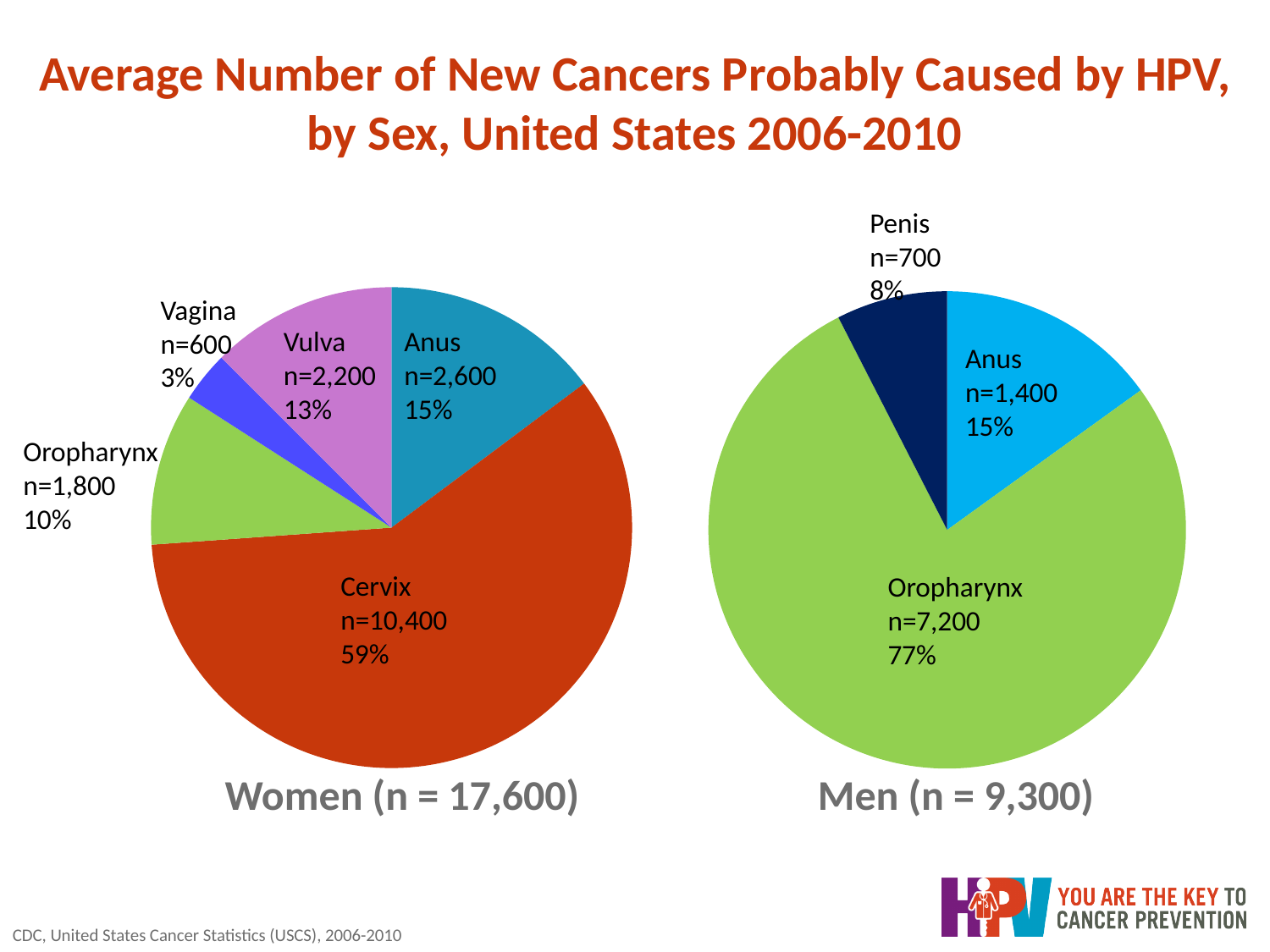
What type of chart is used on this slide? Pie chart In the Men pie chart, what is the difference in number between Oropharynx and Anus cancers? 5,800 How many cancer sites are shown in the Men pie chart? 3 In the Women pie chart, what is the difference in number between Anus and Vulva cancers? 400 In the Women pie chart, which cancer site has the largest slice? Cervix In the Men pie chart, which cancer site has the smallest slice? Penis In the Women pie chart, which cancer site has the smallest slice? Vagina How many cancer sites are shown in the Women pie chart? 5 Which is larger: the number of Oropharynx cancers in women or in men? Men In the Men pie chart, what share of cancers is Oropharynx? 77% What is the total number of cancers shown for Men? 9,300 In the Women pie chart, how many new cancers are attributed to Cervix? n=10,400